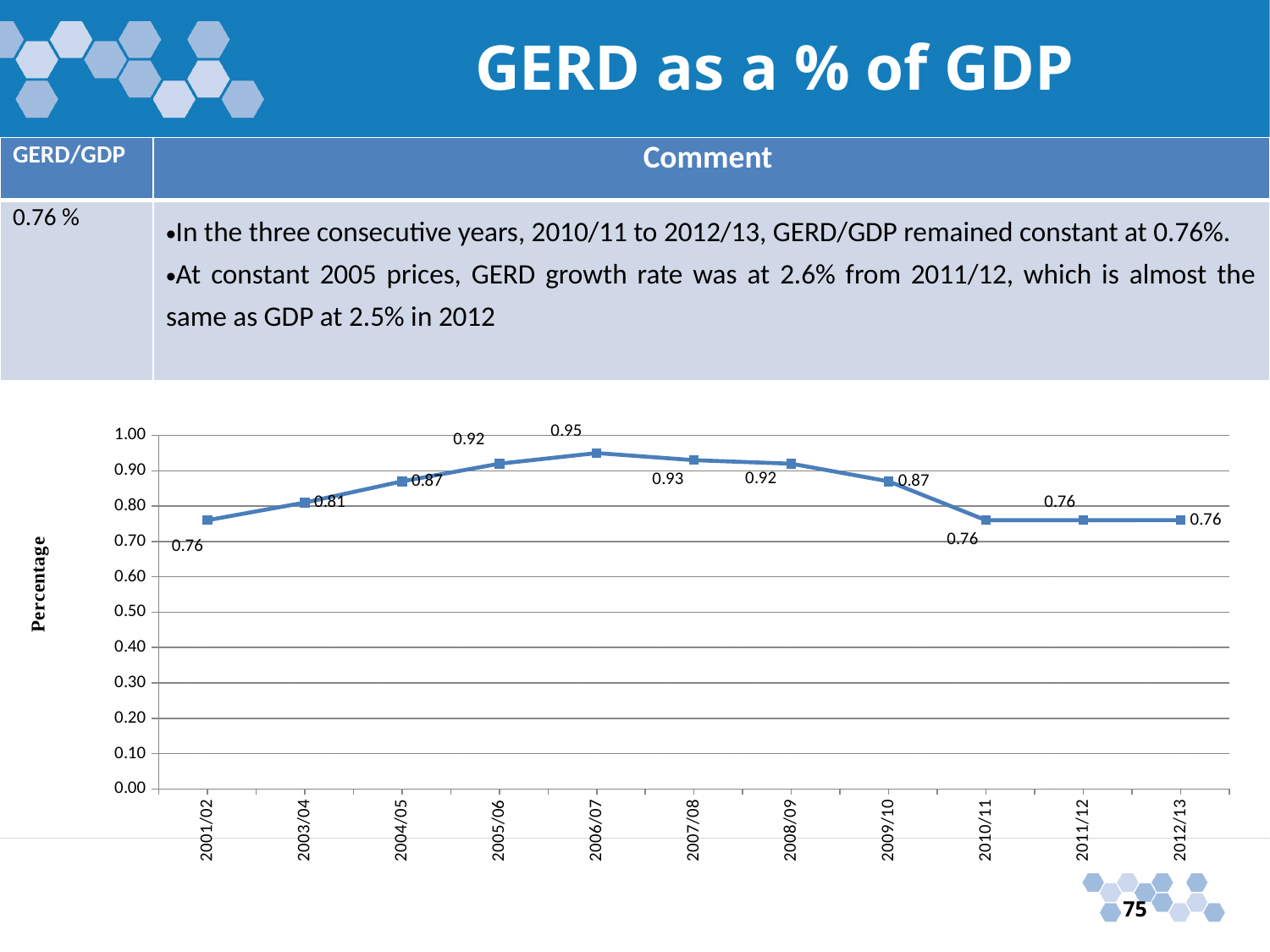
What is the value plotted for 2003/04? 0.81 Do the values rise or fall from 2006/07 to 2010/11? fall What is the value plotted for 2012/13? 0.76 How many years are plotted on the x axis? 11 What is the value plotted for 2009/10? 0.87 What is the difference between the values for 2006/07 and 2010/11? 0.19 Which is larger, the value for 2005/06 or the value for 2007/08? 2007/08 What is the label on the vertical axis of the chart? Percentage Which year has the highest value on the chart? 2006/07 What is the GERD as a % of GDP value for 2006/07? 0.95 What is the lowest value shown on the chart? 0.76 What type of chart is shown on the slide? line chart